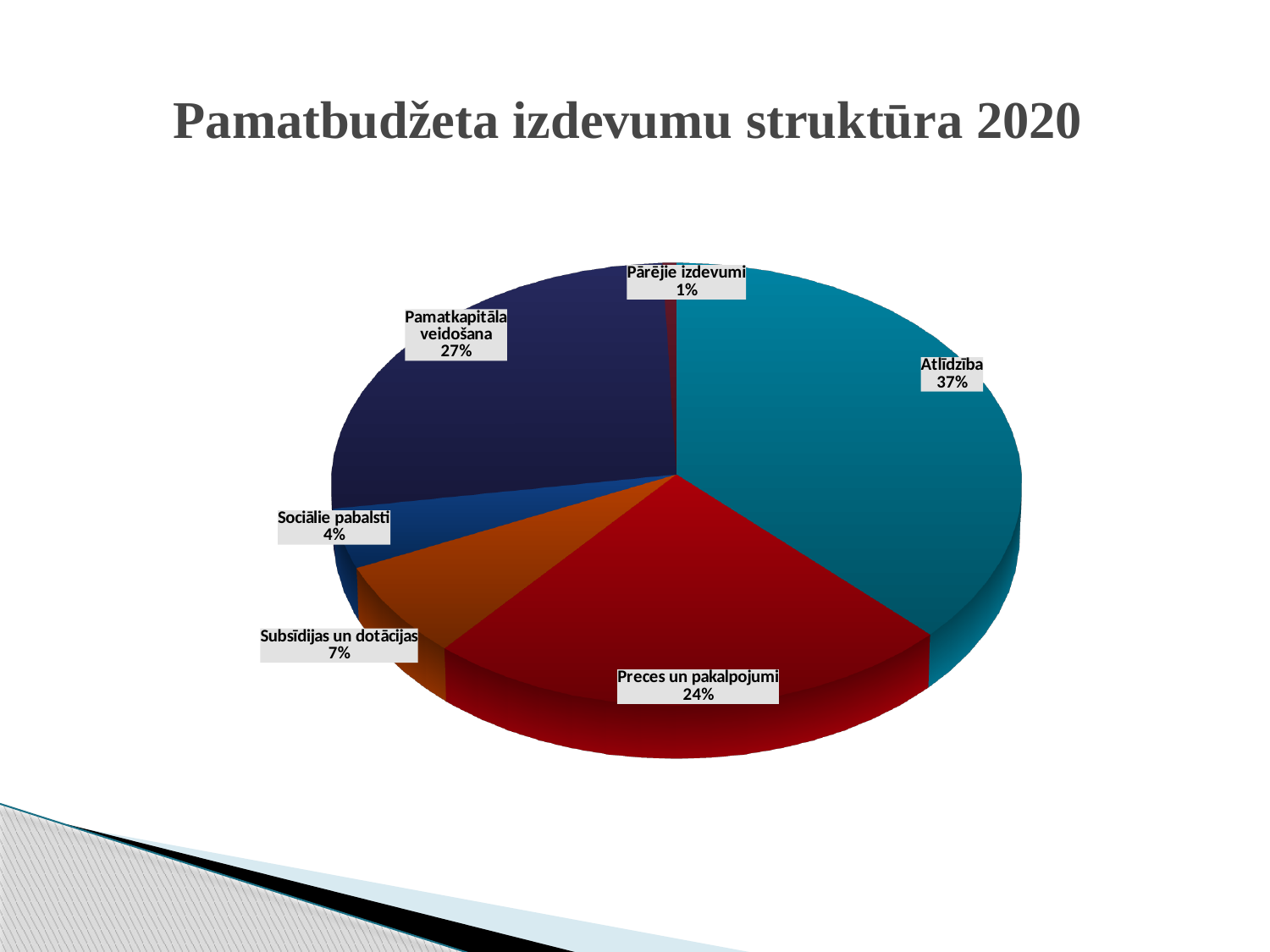
What is the title of the chart? Pamatbudžeta izdevumu struktūra 2020 What is the difference between the shares of Atlīdzība and Preces un pakalpojumi? 13% Which category has the largest share of the pie? Atlīdzība What share of the pie does Pamatkapitāla veidošana represent? 27% What kind of chart is shown on the slide? pie chart What is the value shown for Sociālie pabalsti? 4% What is the value shown for Preces un pakalpojumi? 24% How many categories are shown in the pie chart? 6 What share of the pie does Atlīdzība represent? 37% Which is larger, the share for Pamatkapitāla veidošana or the share for Preces un pakalpojumi? Pamatkapitāla veidošana What is the value shown for Subsīdijas un dotācijas? 7% Which category has the smallest share of the pie? Pārējie izdevumi